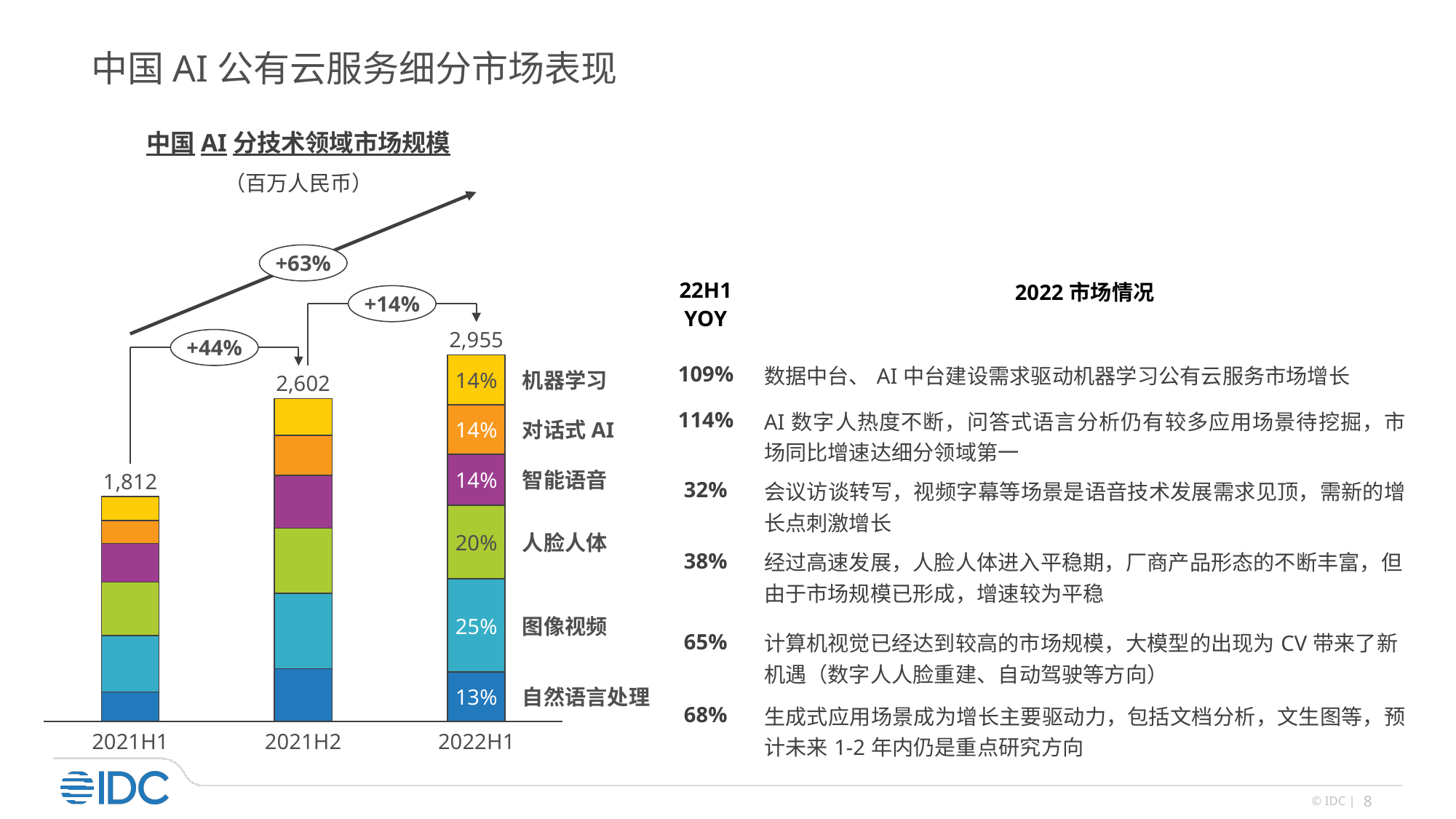
How many periods are shown on the x axis? 3 What growth rate is annotated between 2021H1 and 2022H1? +63% Which period has the highest total market size? 2022H1 What is the total market size shown for 2021H2? 2,602 What is the total market size shown for 2021H1? 1,812 What kind of chart is shown on the slide? Stacked bar chart What is the difference between the 2022H1 total and the 2021H2 total? 353 Which period has the lowest total market size? 2021H1 What is the total market size shown for 2022H1? 2,955 What share of the 2022H1 bar does 图像视频 account for? 25% What share of the 2022H1 bar does 自然语言处理 account for? 13% What growth rate is annotated between 2021H1 and 2021H2? +44%